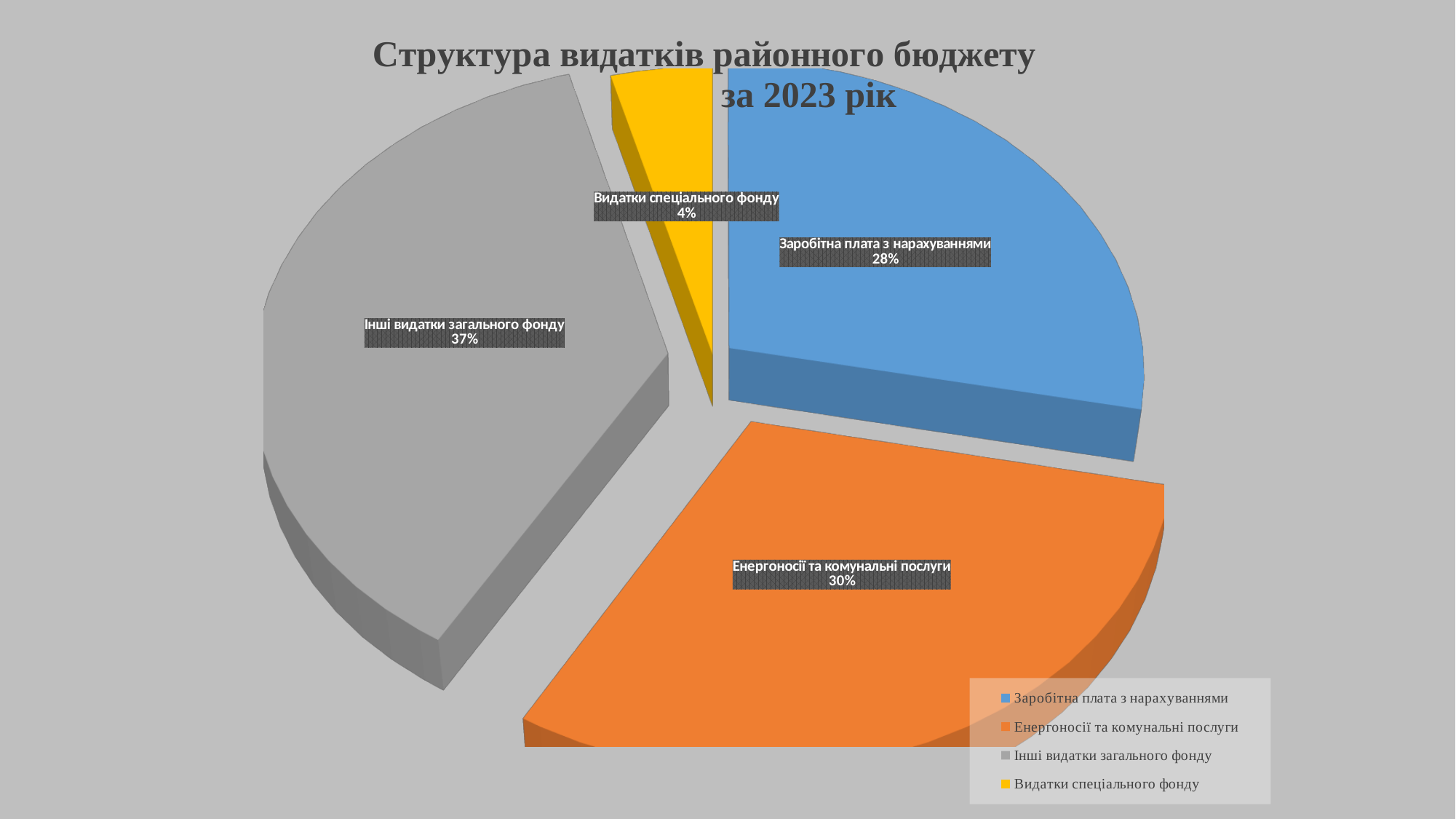
Which category has the smallest slice of the pie? Видатки спеціального фонду What share of the pie does "Енергоносії та комунальні послуги" represent? 30% What is the title of the chart? Структура видатків районного бюджету за 2023 рік Which category has the largest slice of the pie? Інші видатки загального фонду Which is larger: the share for "Енергоносії та комунальні послуги" or the share for "Заробітна плата з нарахуваннями"? Енергоносії та комунальні послуги How many categories are shown in the pie chart? 4 What share of the pie does "Заробітна плата з нарахуваннями" represent? 28% What share of the pie does "Інші видатки загального фонду" represent? 37% What is the difference in percentage points between "Інші видатки загального фонду" and "Заробітна плата з нарахуваннями"? 9 percentage points What kind of chart is shown on the slide? Pie chart What colour is the slice for "Енергоносії та комунальні послуги"? Orange